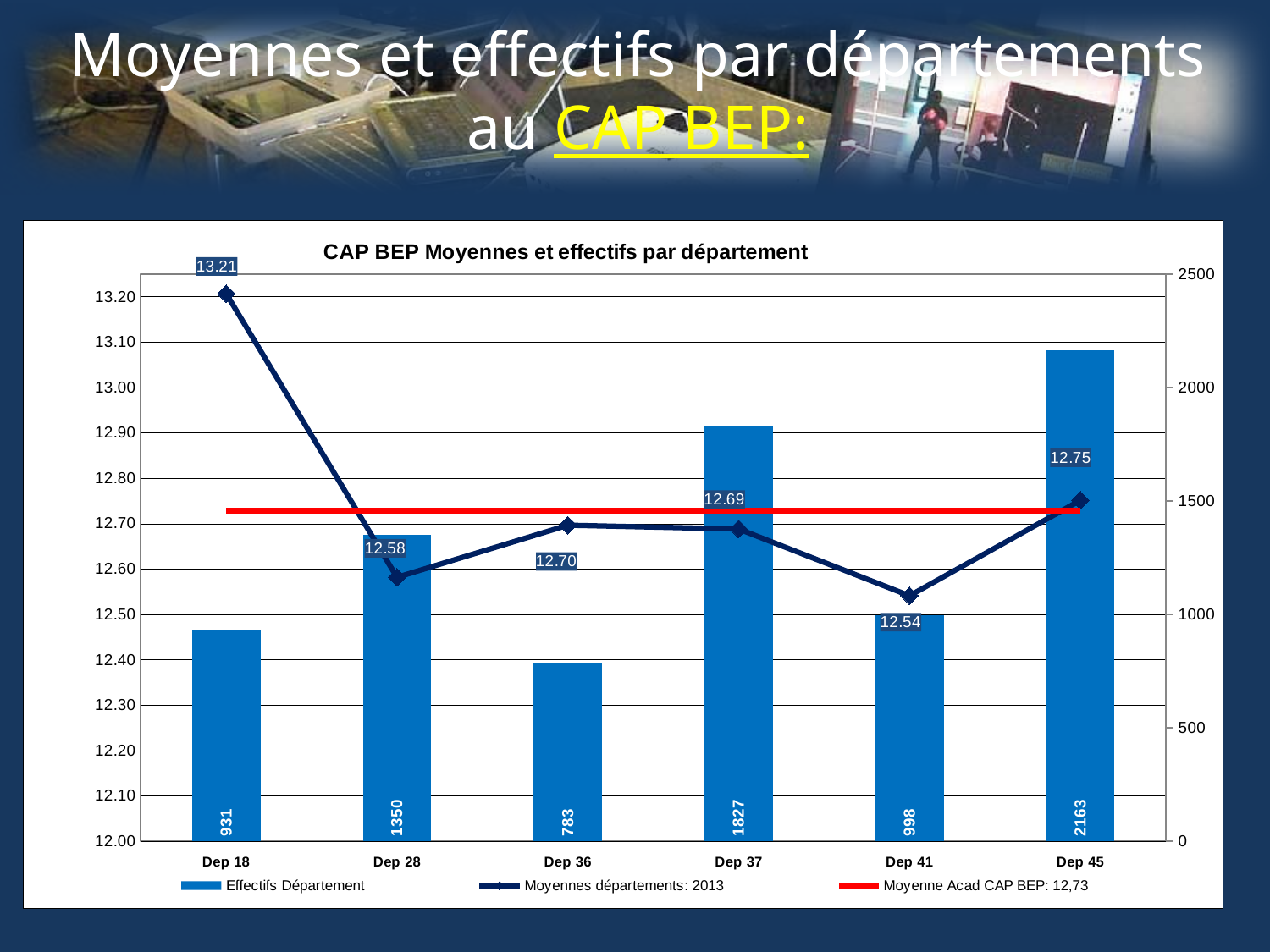
Is the Effectifs Département value for Dep 18 greater or less than 1000? less How many departments are shown on the x axis? 6 What is the Effectifs Département value for Dep 37? 1827 Which department has the lowest Moyennes départements: 2013 value? Dep 41 Which department has the highest Effectifs Département? Dep 45 What value does the legend give for the Moyenne Acad CAP BEP line? 12,73 What is the difference in Effectifs Département between Dep 45 and Dep 36? 1380 How many series does the legend list? 3 What is the Moyennes départements: 2013 value for Dep 45? 12.75 What is the Moyennes départements: 2013 value for Dep 18? 13.21 Which has a larger Effectifs Département, Dep 28 or Dep 41? Dep 28 What is the title of the chart? CAP BEP Moyennes et effectifs par département